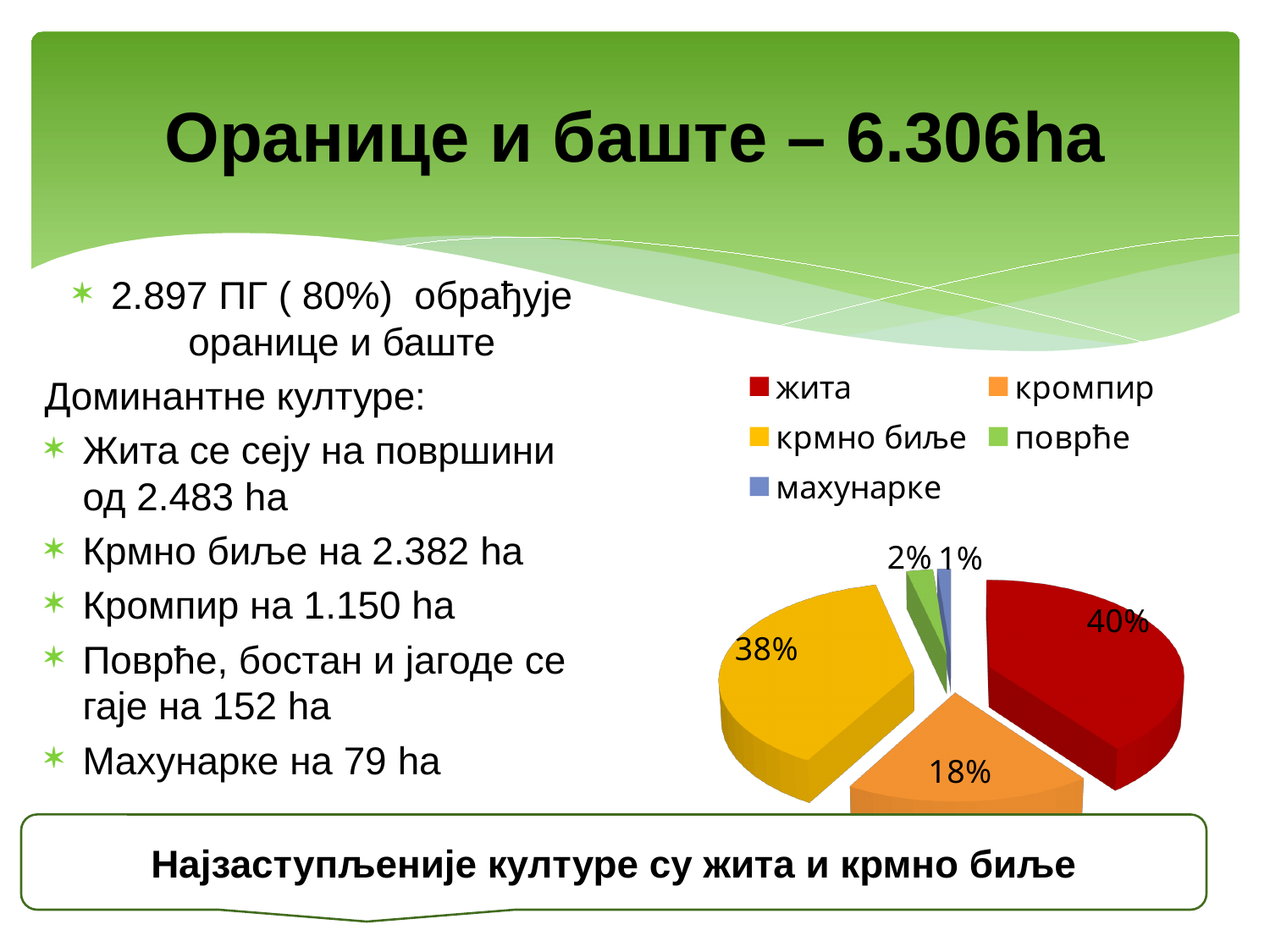
Which category has the largest slice in the pie chart? жита What kind of chart is shown on the slide? pie chart What colour is the жита slice in the pie chart? red What share of the pie chart does поврће have? 2% What share of the pie chart does крмно биље have? 38% What is the difference in percentage points between the жита slice and the кромпир slice? 22 What share of the pie chart does кромпир have? 18% What share of the pie chart does жита have? 40% Which category has the smallest slice in the pie chart? махунарке How many categories does the pie chart legend list? 5 What share of the pie chart does махунарке have? 1% Which is larger in the pie chart, кромпир or крмно биље? крмно биље